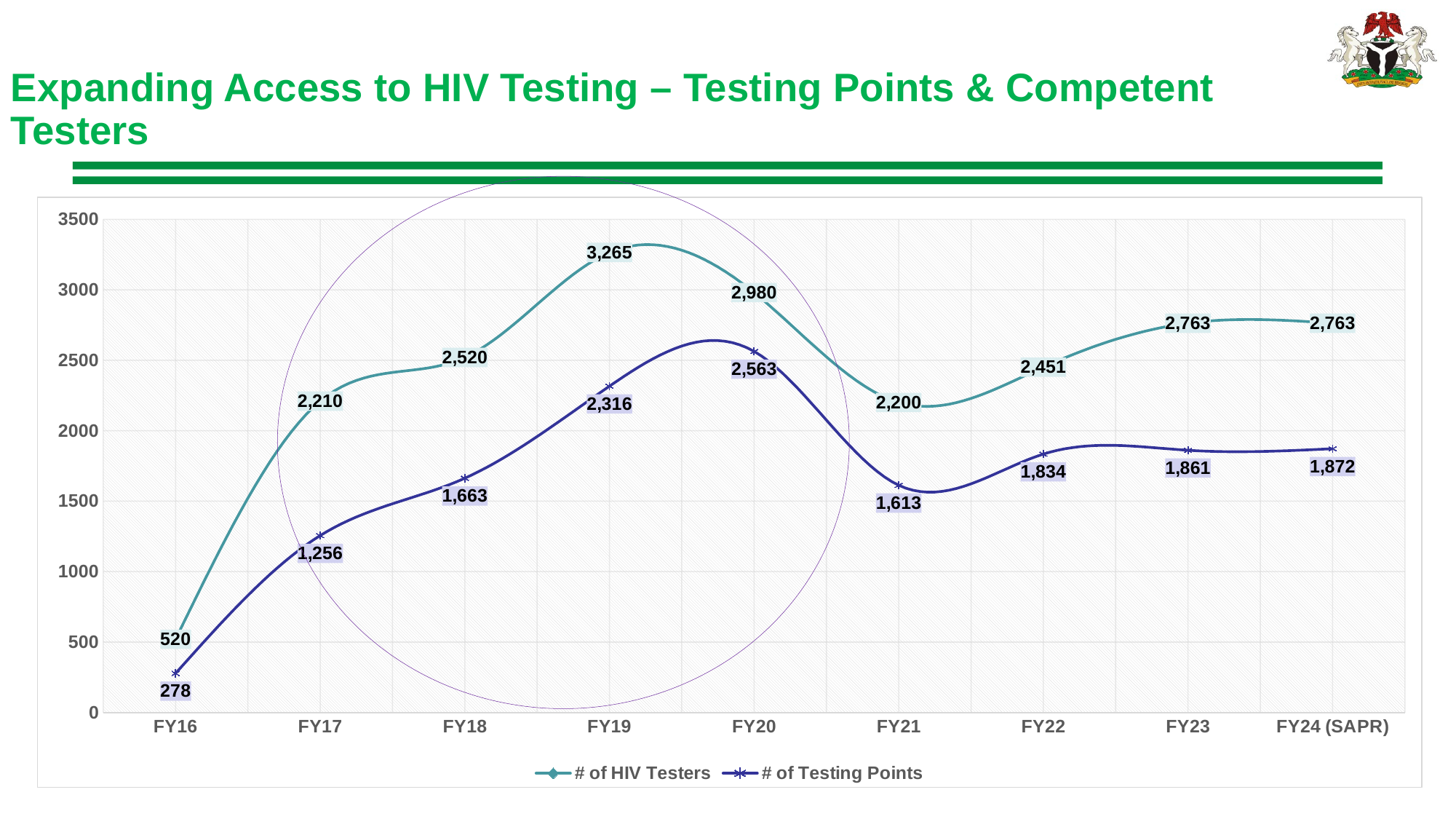
How many series does the legend list? 2 What is the number of Testing Points in FY21? 1,613 Does the number of HIV Testers rise or fall from FY19 to FY21? Fall What is the number of Testing Points in FY24 (SAPR)? 1,872 How many fiscal years are shown on the x axis? 9 What is the number of HIV Testers in FY19? 3,265 What kind of chart is shown on the slide? Line chart In which fiscal year is the number of Testing Points lowest? FY16 Which is larger: the number of Testing Points in FY22 or in FY18? FY22 What are the two series named in the legend? # of HIV Testers and # of Testing Points In which fiscal year is the number of HIV Testers highest? FY19 What is the difference between the number of HIV Testers and the number of Testing Points in FY20? 417